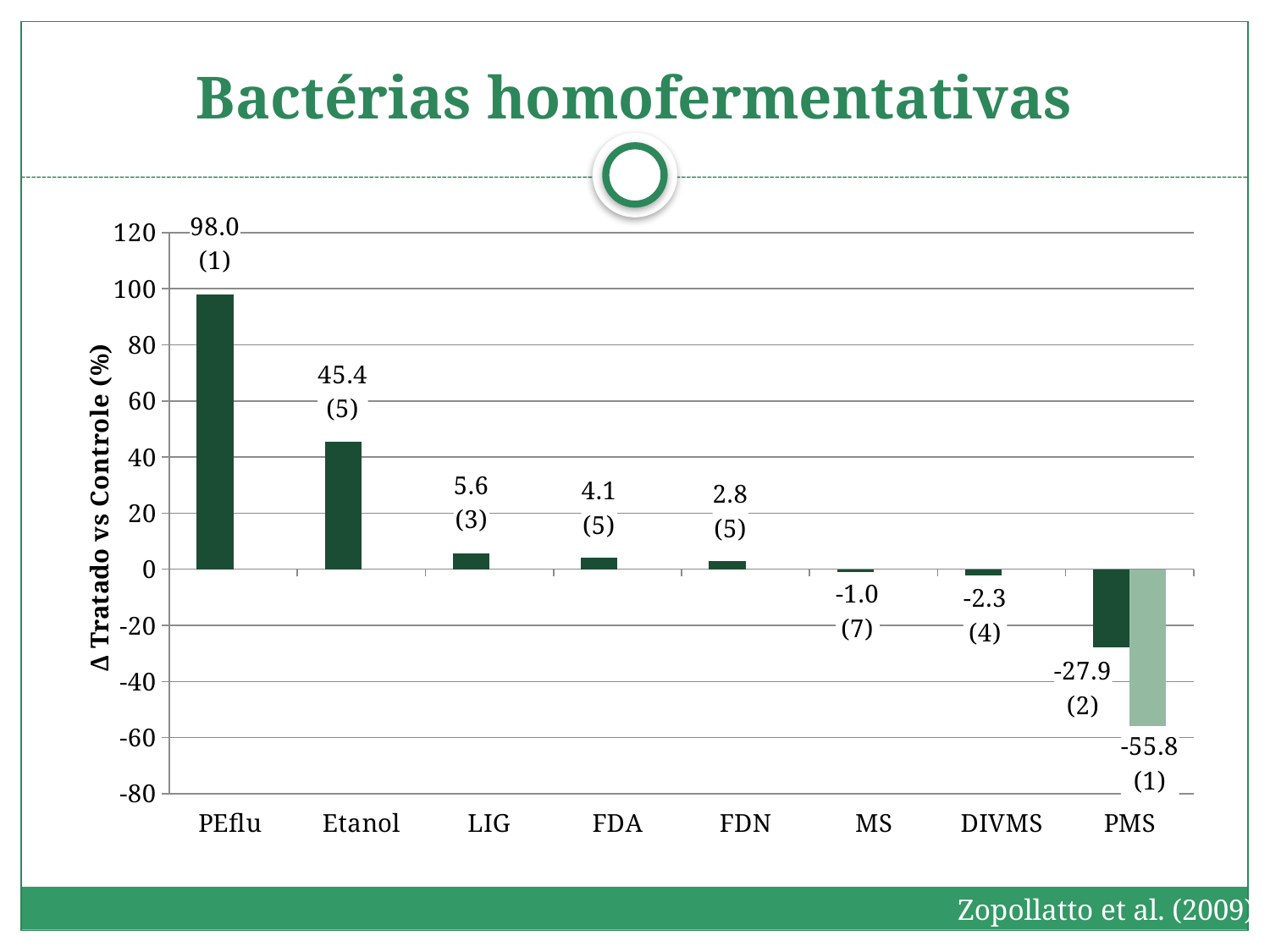
Which category has the lowest value? PMS What is the value for FDN? 2.8 Which category has the highest value? PEflu What is the value of the light green bar for PMS? -55.8 What is the value of the dark green bar for PMS? -27.9 What is the label of the y axis? Δ Tratado vs Controle (%) What kind of chart is shown on the slide? Bar chart How many categories are shown on the x axis? 8 What is the value for PEflu? 98.0 Which is larger, the value for LIG or the value for FDA? LIG What is the value for Etanol? 45.4 What is the difference between the values for PEflu and Etanol? 52.6